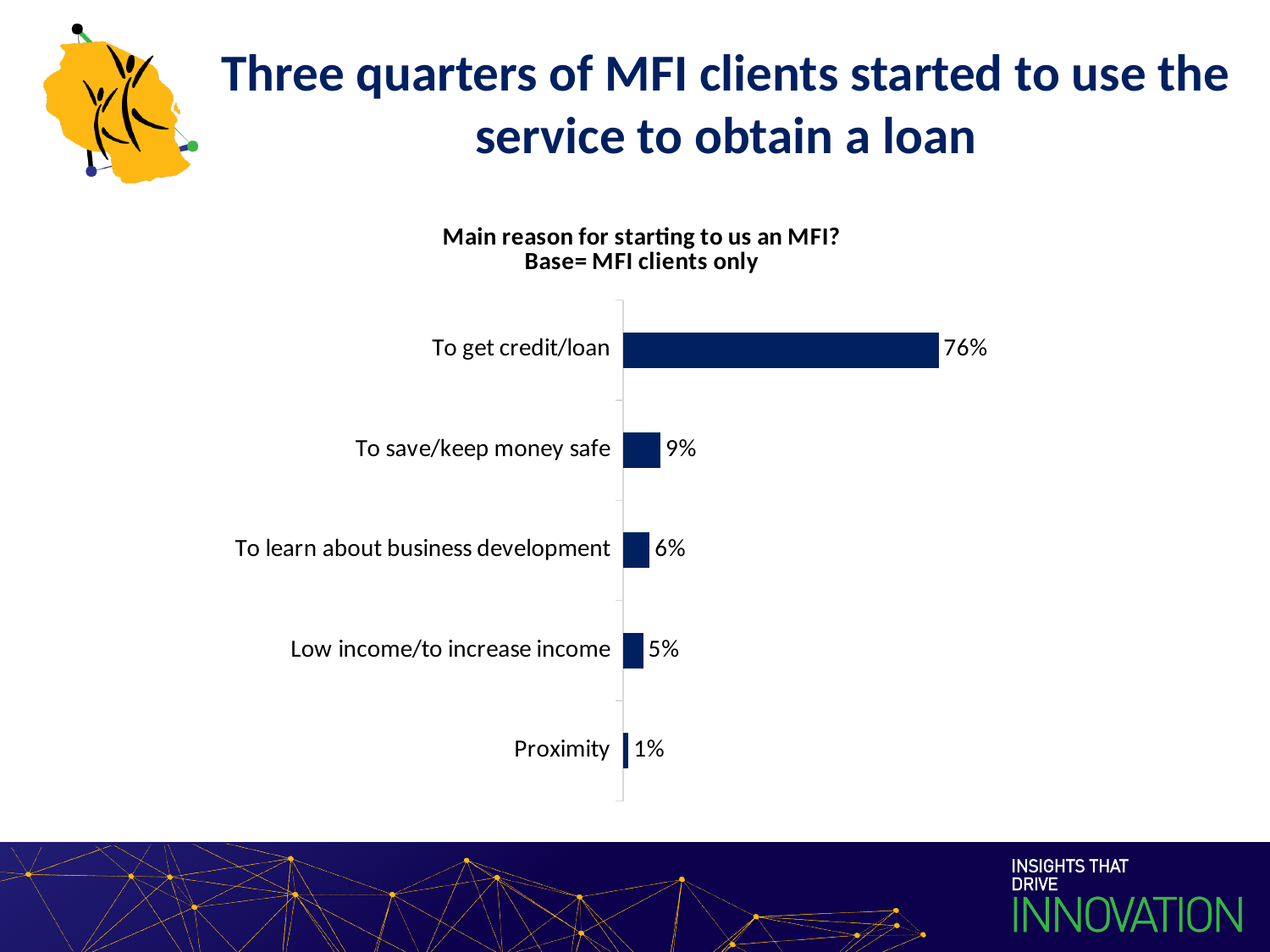
What percentage of MFI clients cited proximity as their main reason? 1% What is the title of the chart? Main reason for starting to us an MFI? Base= MFI clients only What percentage of MFI clients said their main reason for starting to use an MFI was to get credit/loan? 76% Which reason has the lowest percentage? Proximity What type of chart is shown on the slide? Bar chart How many reasons (categories) are shown in the chart? 5 Which is larger: the value for 'To save/keep money safe' or for 'To learn about business development'? To save/keep money safe Which reason has the highest percentage? To get credit/loan What is the value shown for 'To save/keep money safe'? 9% What is the value for 'Low income/to increase income'? 5% What is the difference in percentage points between 'To get credit/loan' and 'To save/keep money safe'? 67 What percentage is shown for 'To learn about business development'? 6%